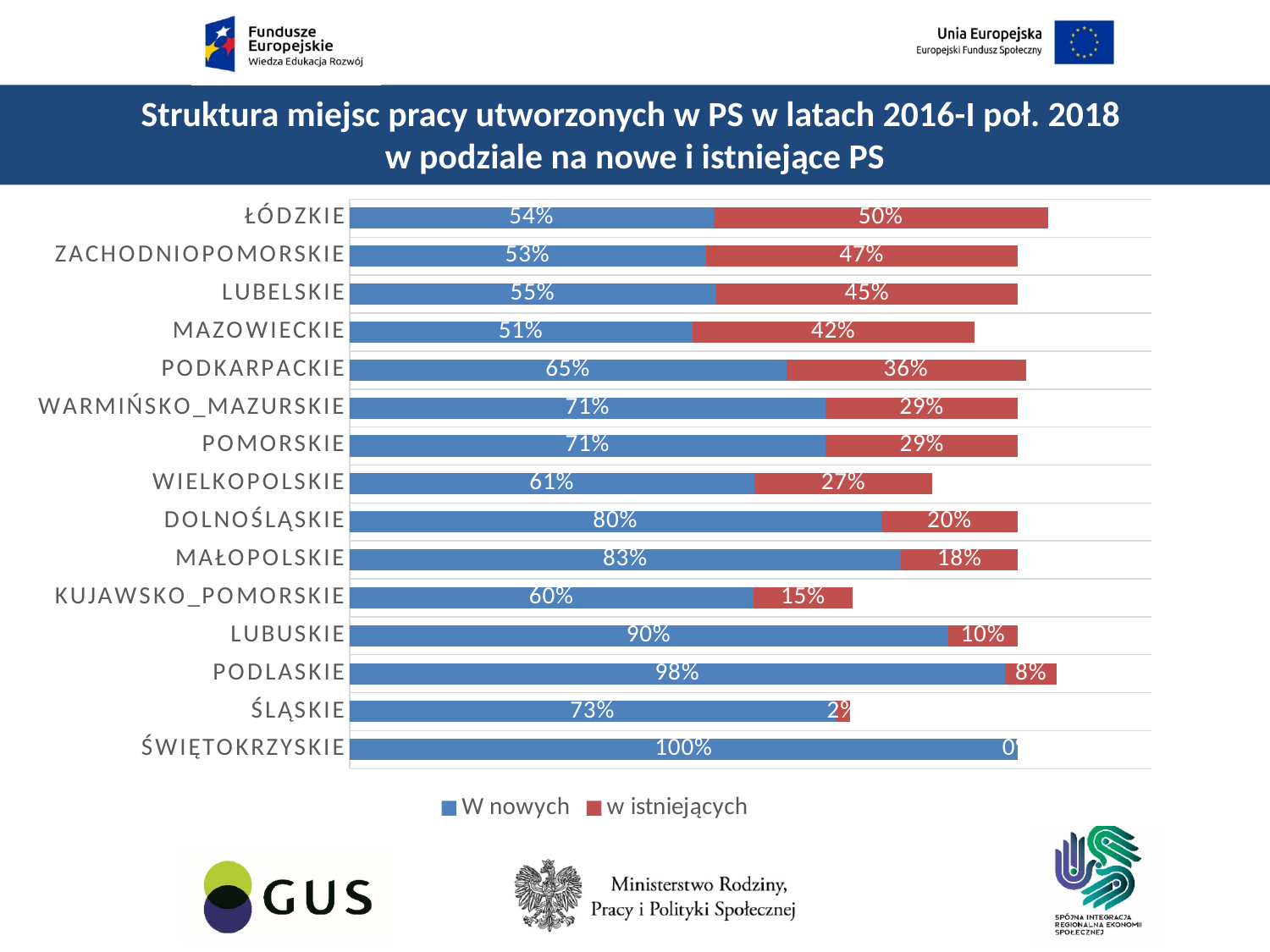
What kind of chart is shown on the slide? Stacked bar chart How many regions are shown on the chart? 15 What is the value of "W nowych" for LUBUSKIE? 90% Which region has the highest value for "W nowych"? ŚWIĘTOKRZYSKIE What are the two legend entries of the chart? W nowych and w istniejących What is the value of "w istniejących" for ŚLĄSKIE? 2% Which has the larger "w istniejących" value, ZACHODNIOPOMORSKIE or MAZOWIECKIE? ZACHODNIOPOMORSKIE What is the value of "w istniejących" for PODKARPACKIE? 36% How many series does the legend list? 2 What is the difference between the "W nowych" values for MAŁOPOLSKIE and DOLNOŚLĄSKIE? 3 percentage points Which region has the highest value for "w istniejących"? ŁÓDZKIE Which region has the lowest value for "W nowych"? MAZOWIECKIE